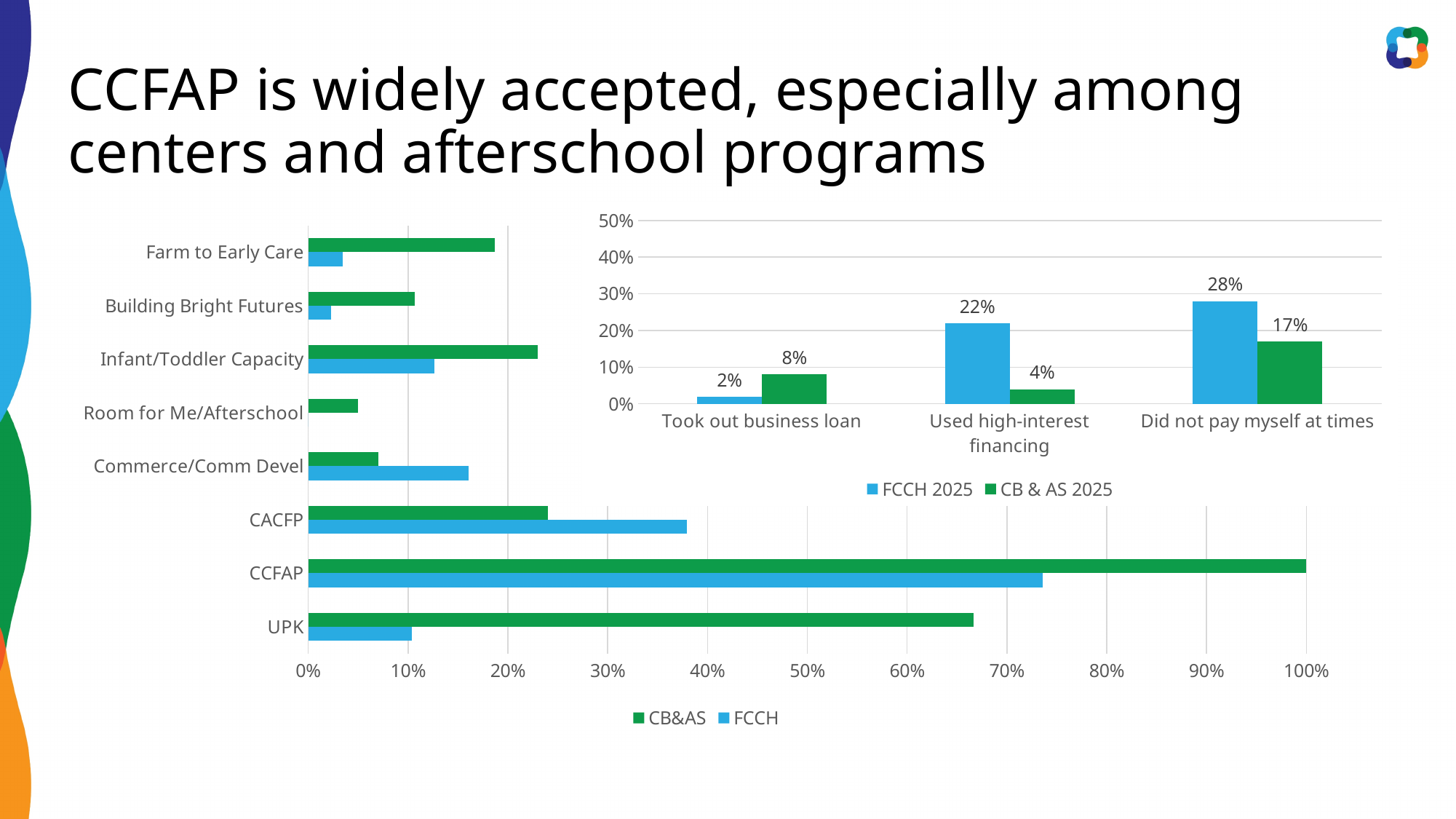
In the smaller chart in the upper right, what is the difference between the FCCH 2025 and CB & AS 2025 values for "Used high-interest financing"? 18% In the smaller chart in the upper right, what is the CB & AS 2025 value for "Took out business loan"? 8% In the smaller chart in the upper right, how many series does the legend list? 2 In the large horizontal bar chart, which series has the larger value for CACFP, CB&AS or FCCH? FCCH In the large horizontal bar chart, how many categories are listed on the vertical axis? 8 In the smaller chart in the upper right, how many categories are shown on the x axis? 3 In the large horizontal bar chart, is the CB&AS value for CCFAP greater or less than 90%? greater In the smaller chart in the upper right, which category has the highest FCCH 2025 value? Did not pay myself at times In the smaller chart in the upper right, what is the FCCH 2025 value for "Did not pay myself at times"? 28% In the large horizontal bar chart, which category has the highest CB&AS value? CCFAP In the large horizontal bar chart, is the FCCH value for UPK greater or less than 20%? less What kind of chart is the large chart on the left side of the slide? Bar chart